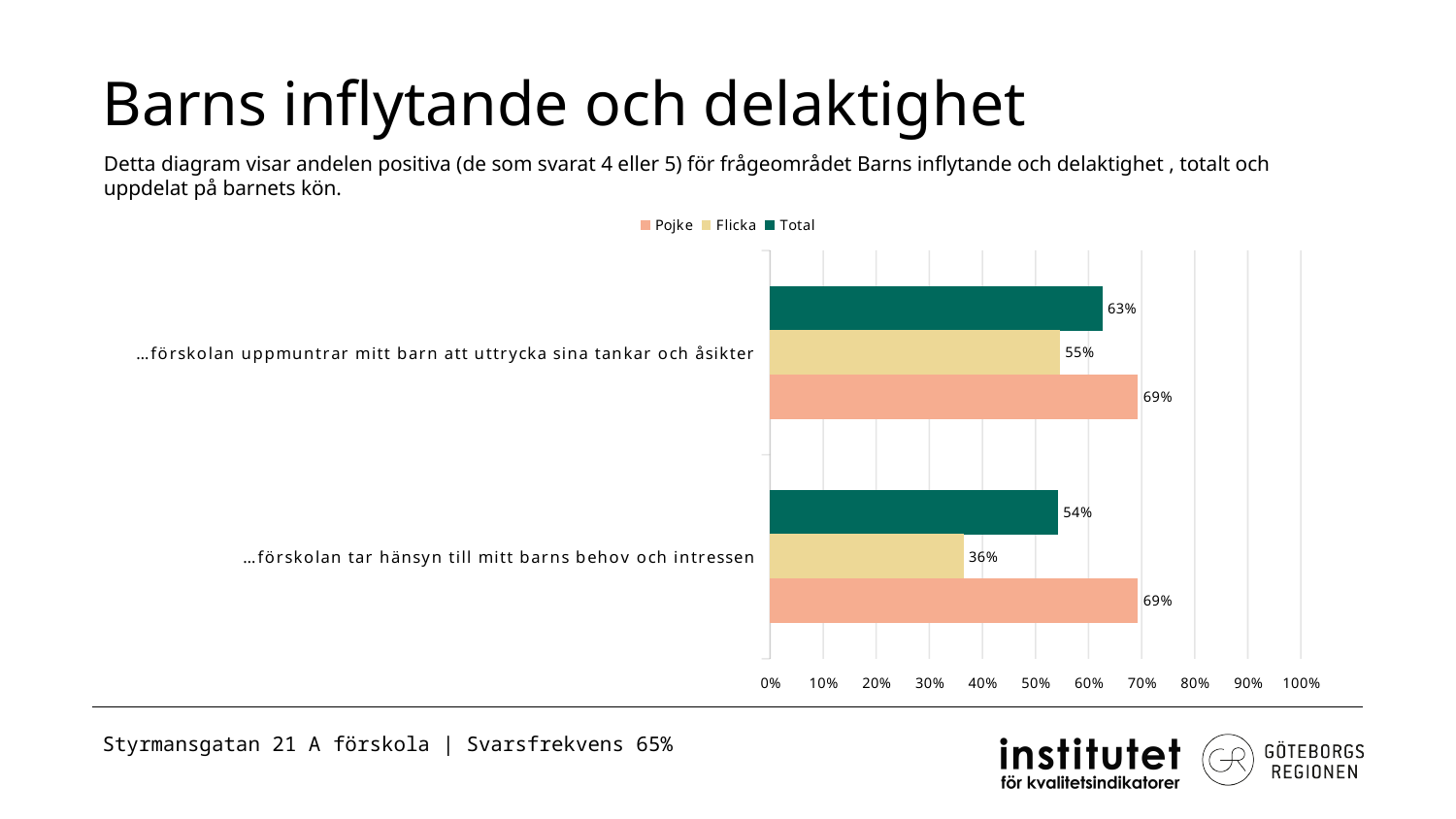
What is the Pojke value for "…förskolan uppmuntrar mitt barn att uttrycka sina tankar och åsikter"? 69% Which series has the lowest value for "…förskolan tar hänsyn till mitt barns behov och intressen"? Flicka What is the Total value for "…förskolan uppmuntrar mitt barn att uttrycka sina tankar och åsikter"? 63% How many series does the legend list? 3 What is the difference between the Pojke and Flicka values for "…förskolan uppmuntrar mitt barn att uttrycka sina tankar och åsikter"? 14% Which series has the highest value for "…förskolan uppmuntrar mitt barn att uttrycka sina tankar och åsikter"? Pojke What is the Total value for "…förskolan tar hänsyn till mitt barns behov och intressen"? 54% How many categories are shown on the chart? 2 Is the Flicka value higher for "…förskolan uppmuntrar mitt barn att uttrycka sina tankar och åsikter" or for "…förskolan tar hänsyn till mitt barns behov och intressen"? …förskolan uppmuntrar mitt barn att uttrycka sina tankar och åsikter What is the difference between the Pojke and Flicka values for "…förskolan tar hänsyn till mitt barns behov och intressen"? 33% What kind of chart is shown on the slide? Bar chart What is the Flicka value for "…förskolan tar hänsyn till mitt barns behov och intressen"? 36%